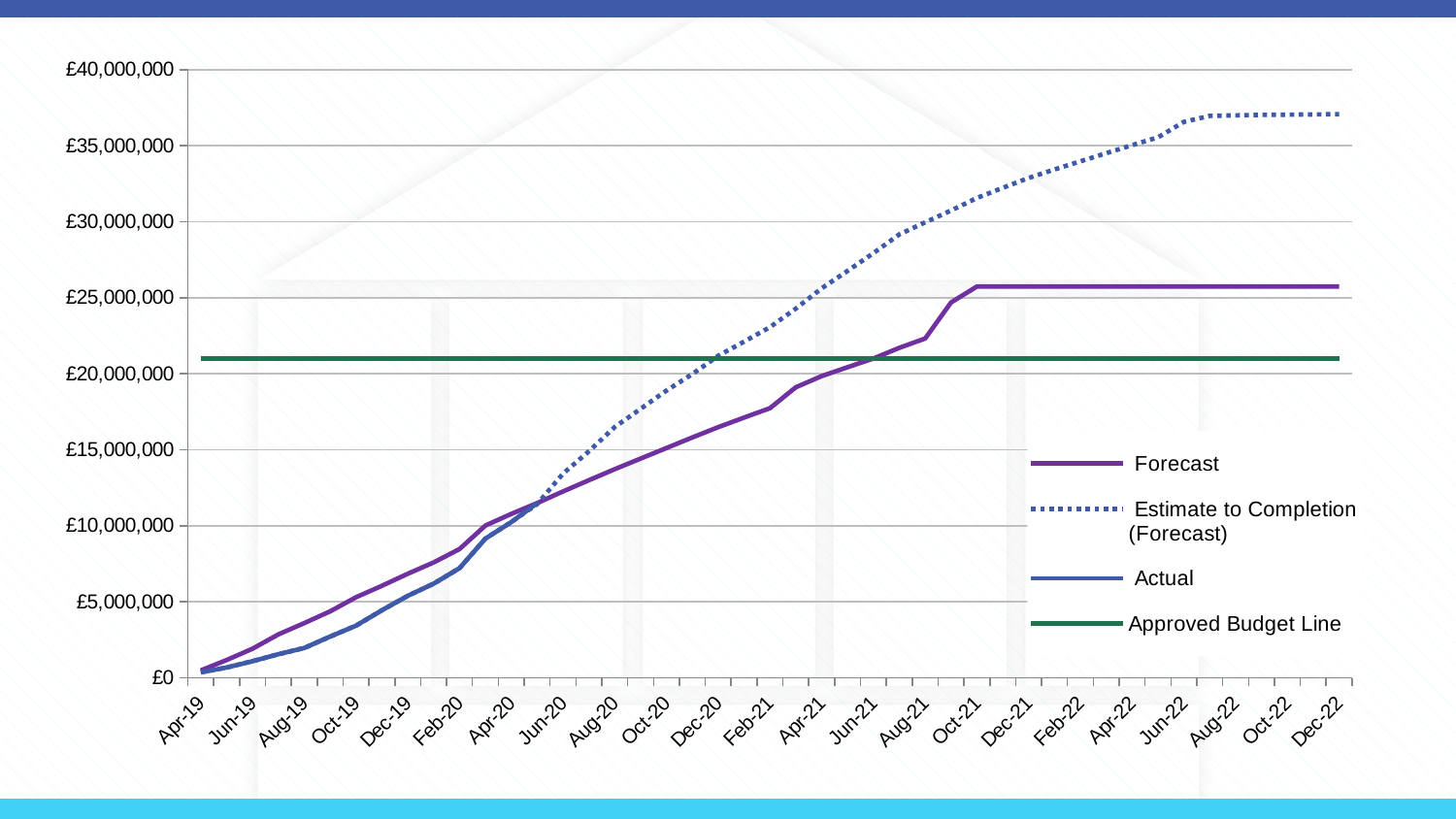
Is the value of the Forecast line at Feb-21 greater or less than £20,000,000? less Does the Estimate to Completion (Forecast) line rise or fall from Jun-20 to Dec-22? Rise Is the value of the Actual line at Oct-19 greater or less than £5,000,000? less What kind of chart is shown on the slide? Line chart Is the Approved Budget Line greater or less than £20,000,000? greater At Dec-22, which is higher: the Forecast line or the Approved Budget Line? Forecast Which series is drawn as a dotted line? Estimate to Completion (Forecast) How many series does the legend list? 4 At Dec-22, which is higher: the Forecast line or the Estimate to Completion (Forecast) line? Estimate to Completion (Forecast) What colour is the Approved Budget Line? Green